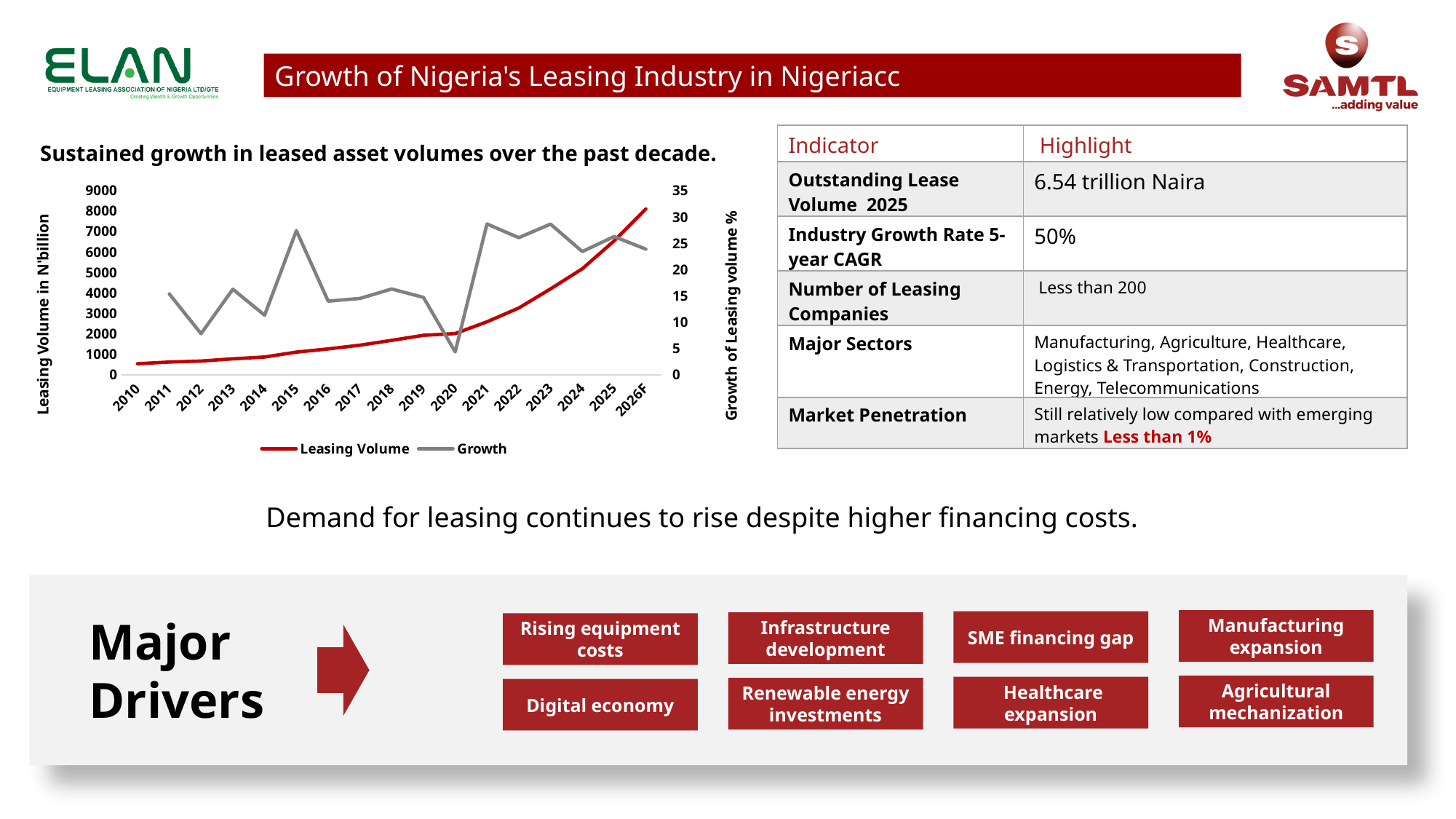
Which year has the lowest Leasing Volume? 2010 Which year has the highest Leasing Volume? 2026F Is the Growth value for 2020 greater or less than 10? less Is the Leasing Volume for 2026F greater or less than 7000? greater What is the title of the left vertical axis of the chart? Leasing Volume in N'billion What kind of chart is shown on the slide? Line chart How many series does the chart legend list? 2 Does the Leasing Volume series rise or fall from 2010 to 2026F? Rise How many years are shown along the x axis of the chart? 17 Which year has the lowest Growth value? 2020 Is the Growth value for 2015 greater or less than 20? greater Which is larger, the Growth value for 2015 or for 2012? 2015